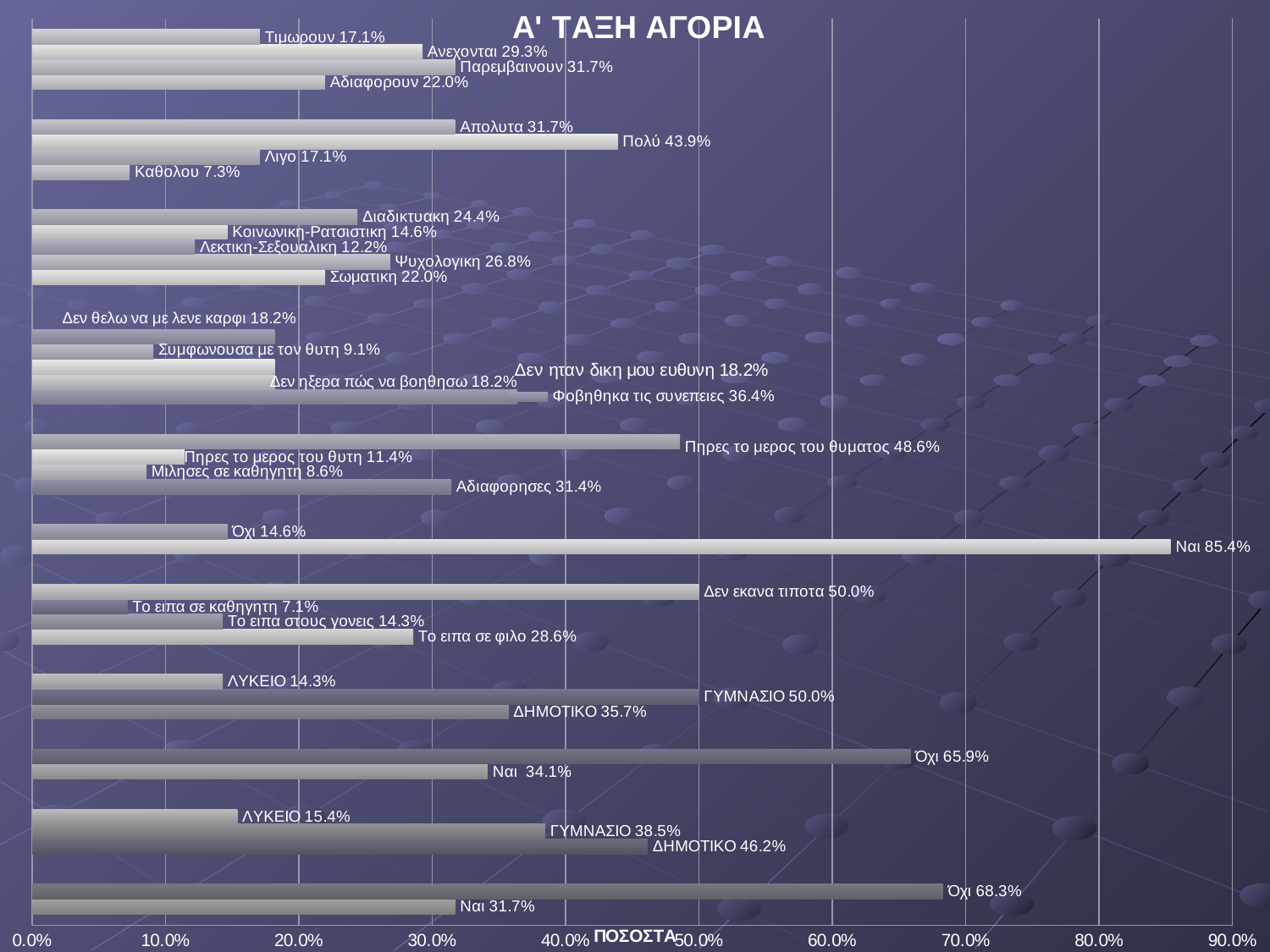
What is the label of the horizontal axis? ΠΟΣΟΣΤΑ What is the difference between the values for Ψυχολογικη and Σωματικη? 4.8% What is the value for Πηρες το μερος του θυματος? 48.6% What is the value for Φοβηθηκα τις συνεπειες? 36.4% What is the value for Το ειπα σε φιλο? 28.6% What is the title of the chart? Α' ΤΑΞΗ ΑΓΟΡΙΑ Which bar has the highest value on the chart? Ναι 85.4% What type of chart is shown on the slide? bar chart Which bar has the lowest value on the chart? Το ειπα σε καθηγητη 7.1% What is the value for Πολύ? 43.9% Which is larger, the value for Διαδικτυακη or the value for Κοινωνικη-Ρατσιστικη? Διαδικτυακη Is the value for Δεν εκανα τιποτα greater or less than 40.0%? greater